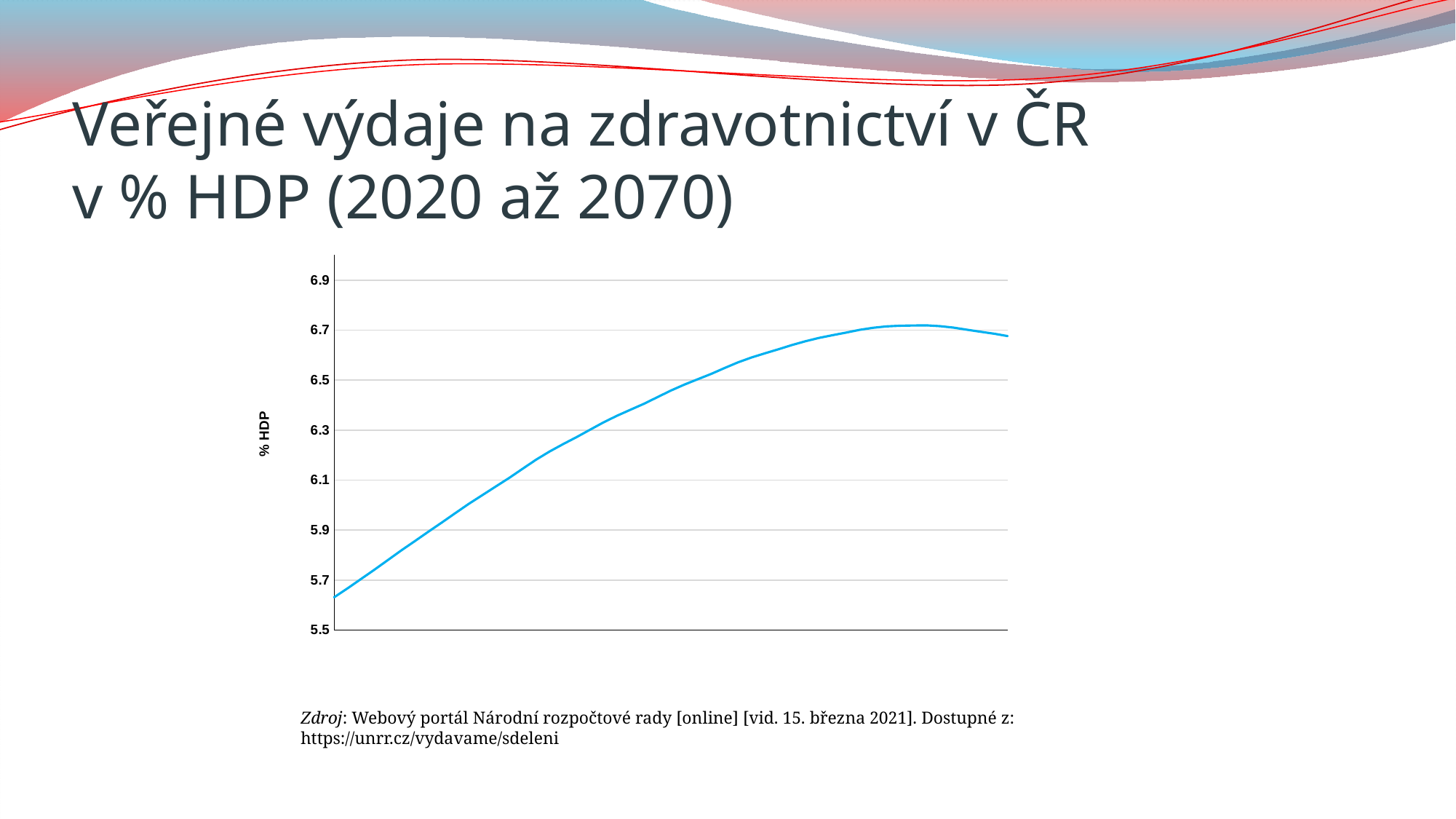
Is the highest point of the line greater or less than 6.9? less Is the value at the right end of the line greater or less than 6.5? greater Which is larger, the value at the left end of the line or the value at the right end? the right end What kind of chart is shown on the slide? line chart Is the value at the left end (start) of the line greater or less than 5.7? less What is the lowest tick value shown on the vertical axis? 5.5 What is the label on the vertical axis? % HDP Do the values generally rise or fall from the left to the right of the chart? rise